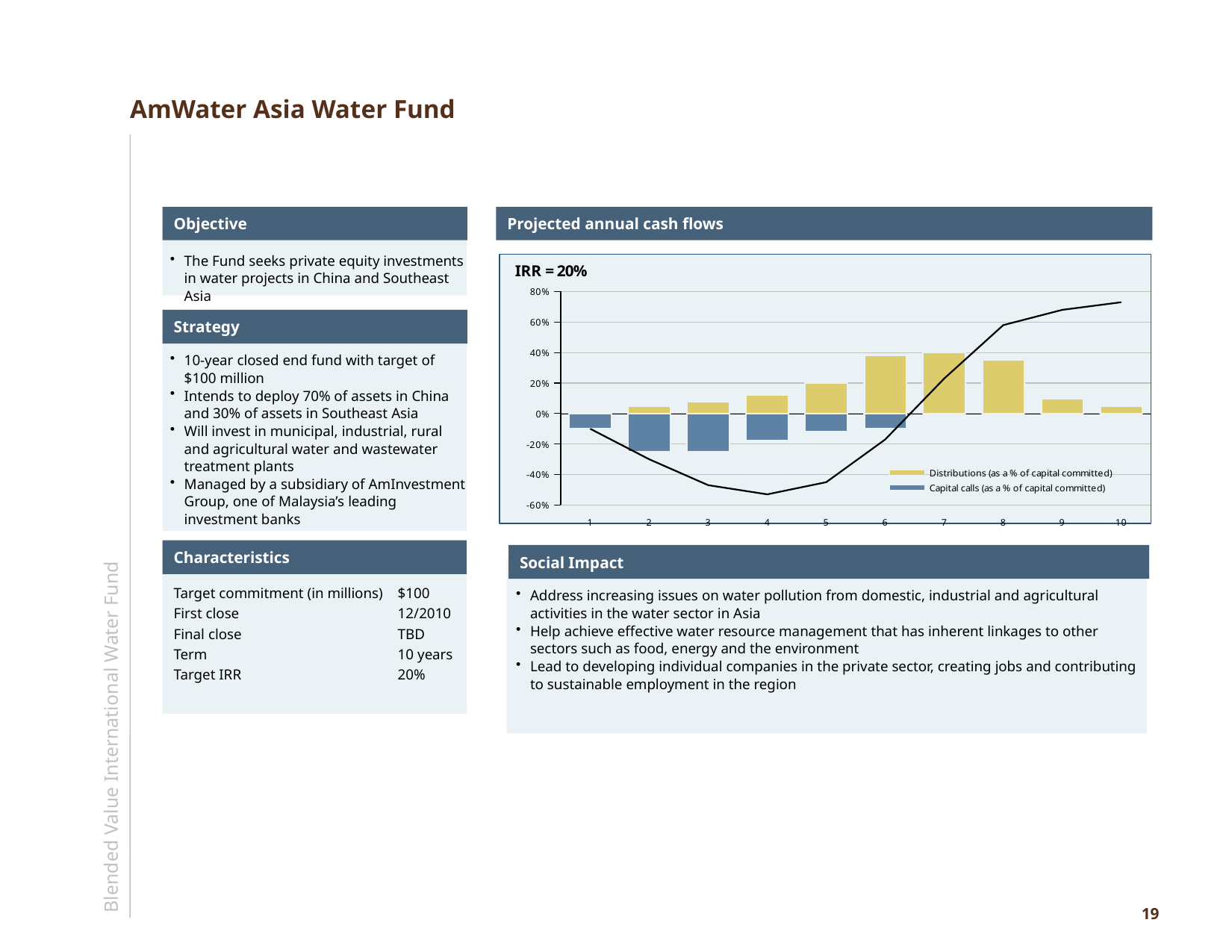
In the projected annual cash flows chart, is the distributions value for year 9 greater or less than 20%? less In the projected annual cash flows chart, is the distributions value for year 6 greater or less than 20%? greater How many years (categories) are shown on the x axis of the projected annual cash flows chart? 10 In the projected annual cash flows chart, is the distributions value for year 8 greater or less than 20%? greater What IRR value is annotated on the projected annual cash flows chart? IRR = 20% How many series does the legend of the projected annual cash flows chart list? 2 What is the title of the chart on the slide? Projected annual cash flows In the projected annual cash flows chart, do the distributions bars rise or fall from year 1 to year 7? Rise In the projected annual cash flows chart, which year has the larger distributions value, year 6 or year 9? Year 6 What kind of chart is used for the projected annual cash flows? Combination bar and line chart In the projected annual cash flows chart, which year has the larger distributions value, year 4 or year 8? Year 8